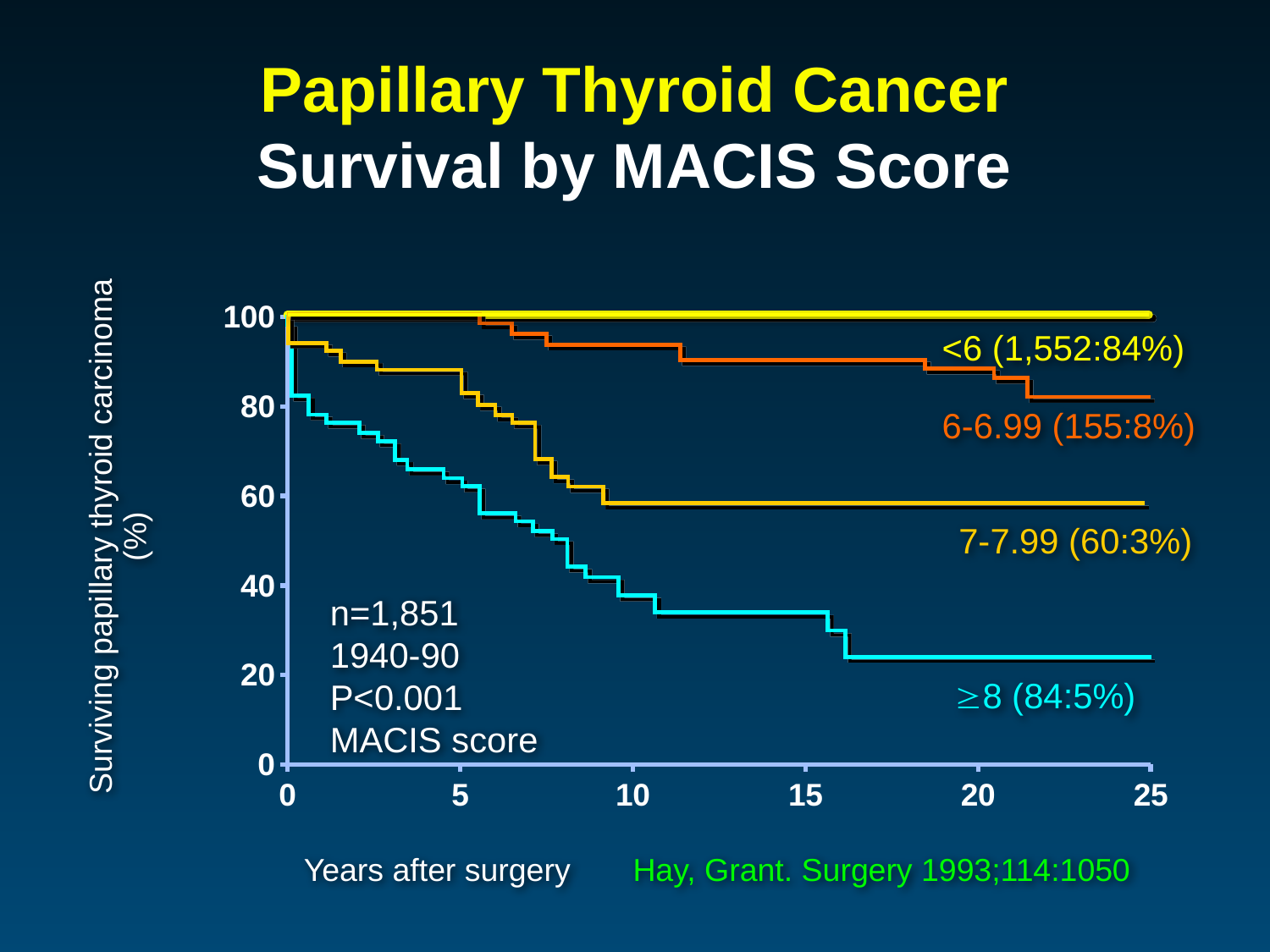
Which MACIS score group has the lowest survival at 25 years after surgery? ≥8 What is the label of the x axis? Years after surgery How many patients are in the <6 MACIS score group according to the chart label? 1,552 How many MACIS score groups (series) are plotted on the chart? 4 What kind of chart is shown on the slide? line chart Do the survival curves rise or fall as years after surgery increase? fall At 15 years after surgery, which group has higher survival: 7-7.99 or ≥8? 7-7.99 Is the survival for the ≥8 group at 25 years greater or less than 40? less Which MACIS score group has the highest survival at 25 years after surgery? <6 What is the total number of patients (n) stated on the chart? n=1,851